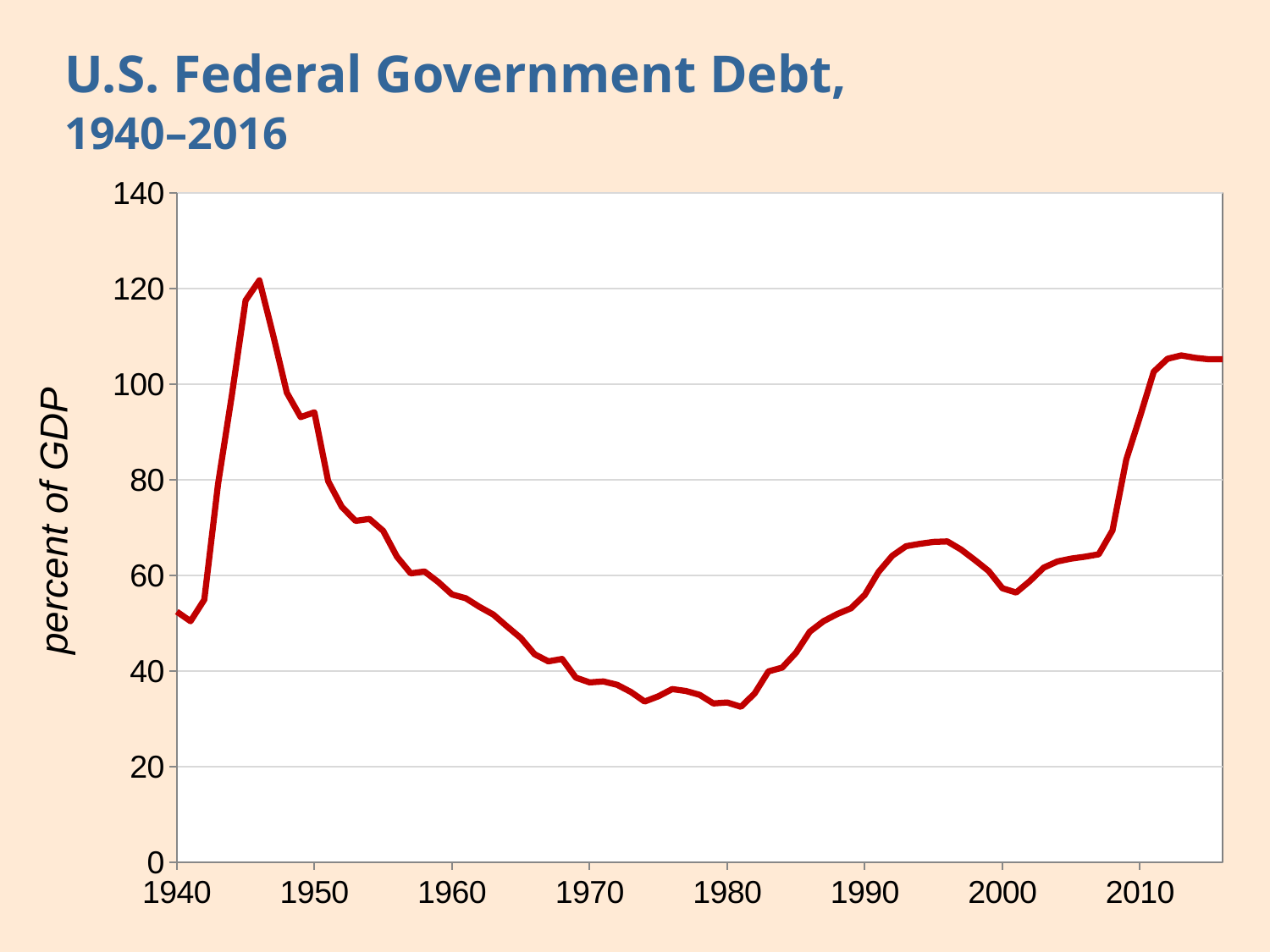
Is the value for 1950 greater or less than 80? greater What kind of chart is shown on the slide? line chart Is the value for 1980 greater or less than 40? less Does the debt-to-GDP ratio rise or fall between 1946 and 1974? fall What is the label on the vertical axis? percent of GDP Is the value for 1970 greater or less than 40? less What is the title of the chart? U.S. Federal Government Debt, 1940–2016 Does the debt-to-GDP ratio rise or fall between 2007 and 2013? rise Which year has the larger value, 1946 or 2016? 1946